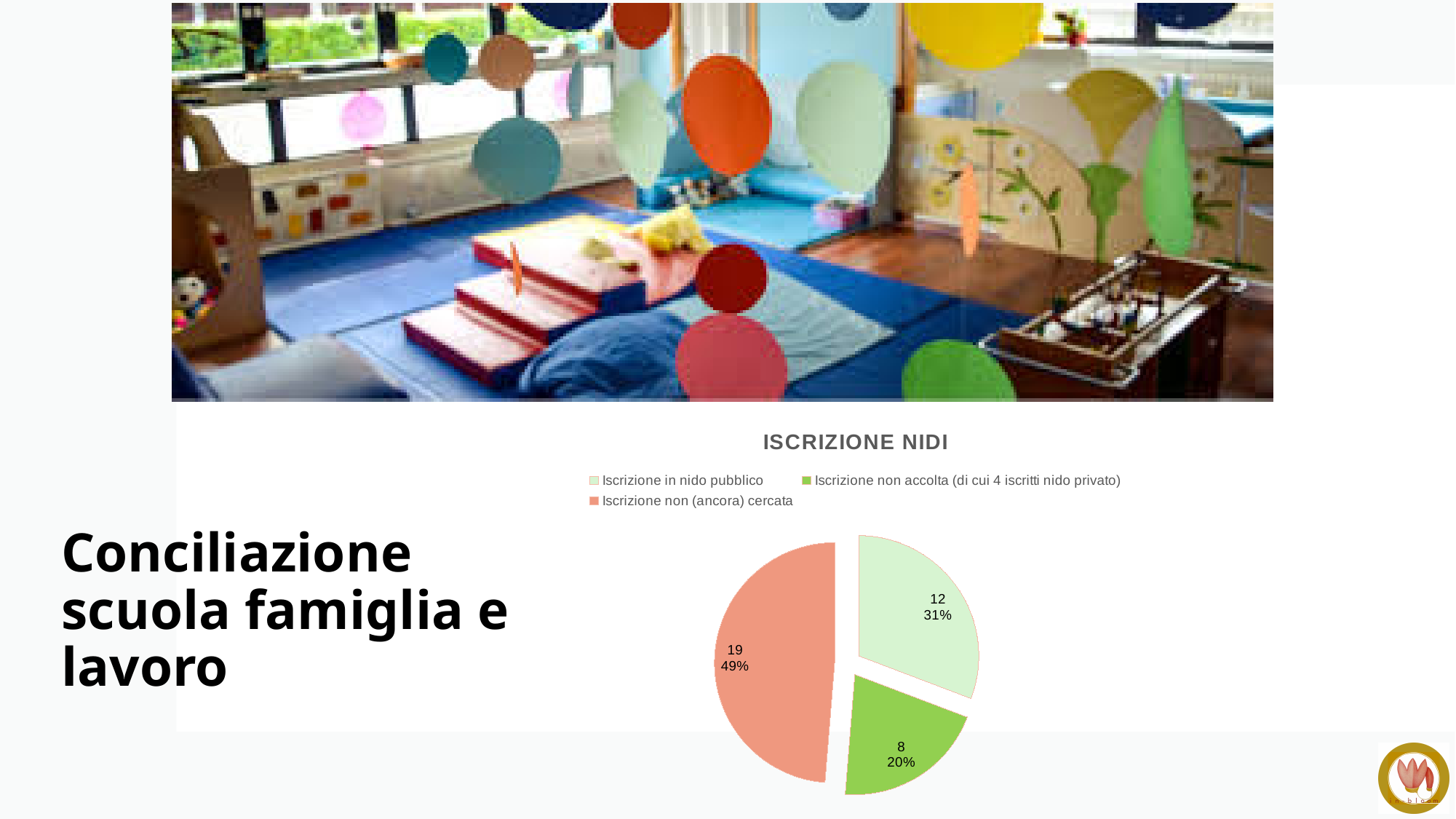
Which category has the largest slice? Iscrizione non (ancora) cercata Which category has the smallest slice? Iscrizione non accolta (di cui 4 iscritti nido privato) How many entries does the legend list? 3 What type of chart is shown under the title ISCRIZIONE NIDI? pie chart What is the title of the chart? ISCRIZIONE NIDI What is the value for 'Iscrizione non accolta (di cui 4 iscritti nido privato)'? 8 What is the difference between the values for 'Iscrizione non (ancora) cercata' and 'Iscrizione in nido pubblico'? 7 What share of the pie does 'Iscrizione in nido pubblico' represent? 31% What is the value for 'Iscrizione non (ancora) cercata'? 19 What is the value for 'Iscrizione in nido pubblico'? 12 What share of the pie does 'Iscrizione non (ancora) cercata' represent? 49% How many slices does the pie chart have? 3